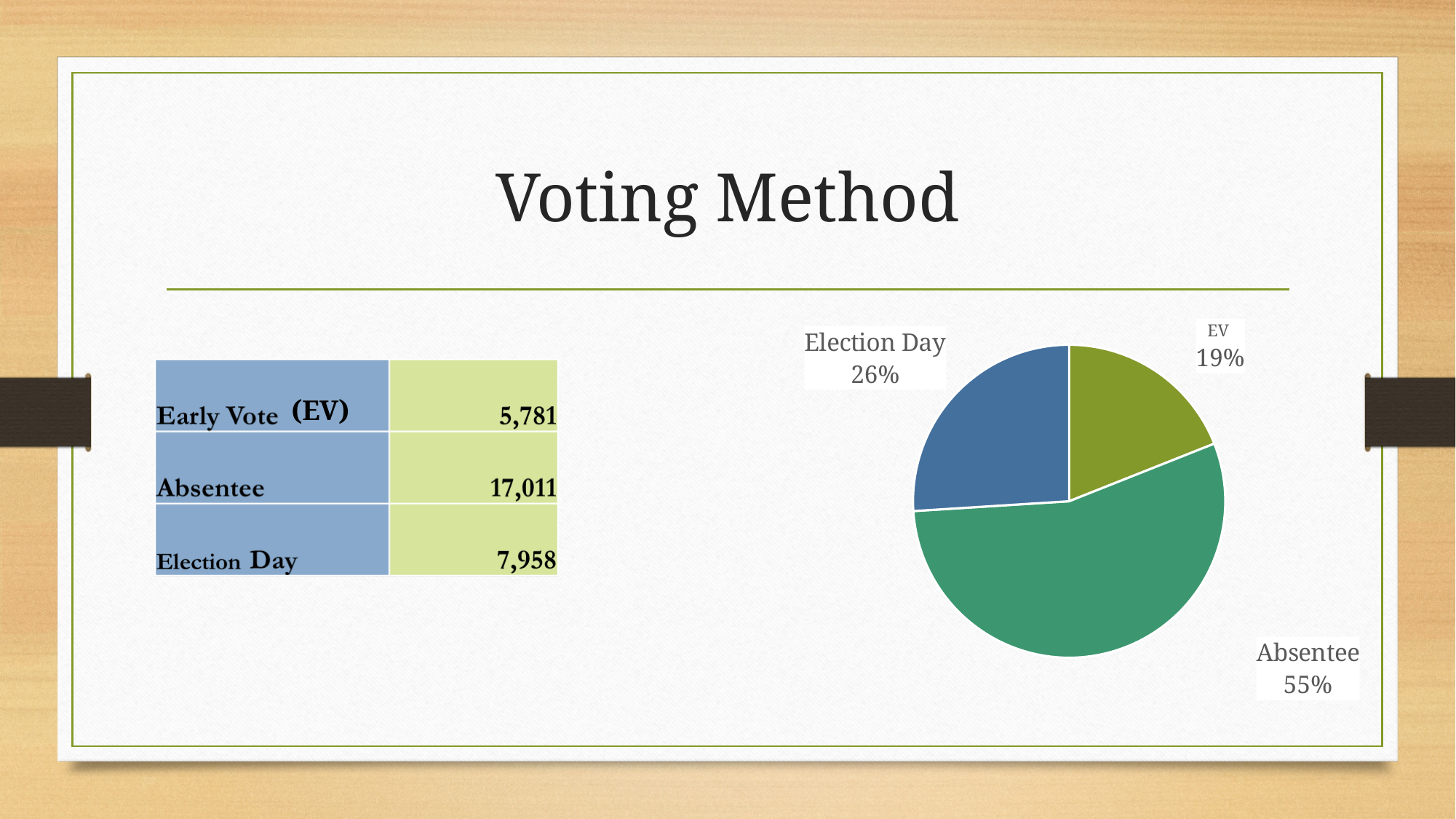
What kind of chart is shown on the slide? pie chart What share of the pie chart does Election Day represent? 26% What colour is the Absentee slice of the pie chart? green What is the difference in percentage points between the Absentee and Election Day slices of the pie chart? 29 Which slice of the pie chart is the smallest? EV What is the difference in percentage points between the Election Day and EV slices of the pie chart? 7 How many slices does the pie chart have? 3 Which slice of the pie chart is the largest? Absentee What share of the pie chart does Absentee represent? 55% In the pie chart, which is larger: Election Day or EV? Election Day What is the title of the slide containing the pie chart? Voting Method What share of the pie chart does EV represent? 19%